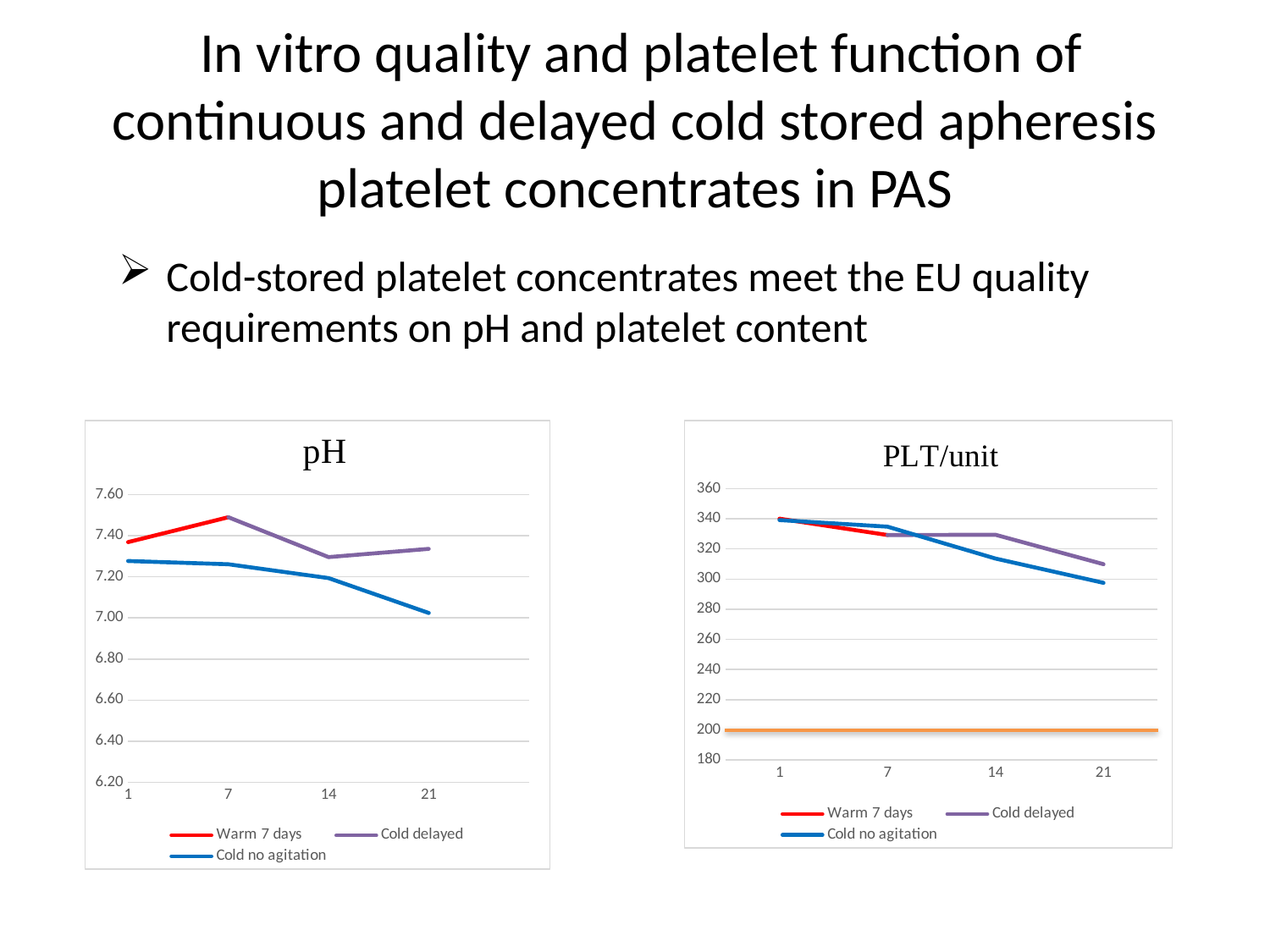
On the PLT/unit chart, is the value for Cold no agitation at day 21 greater or less than 300? less On the pH chart, is the value for Warm 7 days at day 7 greater or less than 7.40? greater On the pH chart, is the value for Cold no agitation at day 21 greater or less than 7.20? less What kind of chart is the pH chart? line chart On the pH chart, does the Cold no agitation line rise or fall from day 1 to day 21? fall On the PLT/unit chart, which is larger at day 21: Cold delayed or Cold no agitation? Cold delayed On the PLT/unit chart, does the Cold no agitation line rise or fall along the x axis? fall On the pH chart, which is larger at day 21: Cold delayed or Cold no agitation? Cold delayed How many x-axis points are plotted on the pH chart? 4 How many series does the legend of the PLT/unit chart list? 3 What is the title of the chart on the right of the slide? PLT/unit